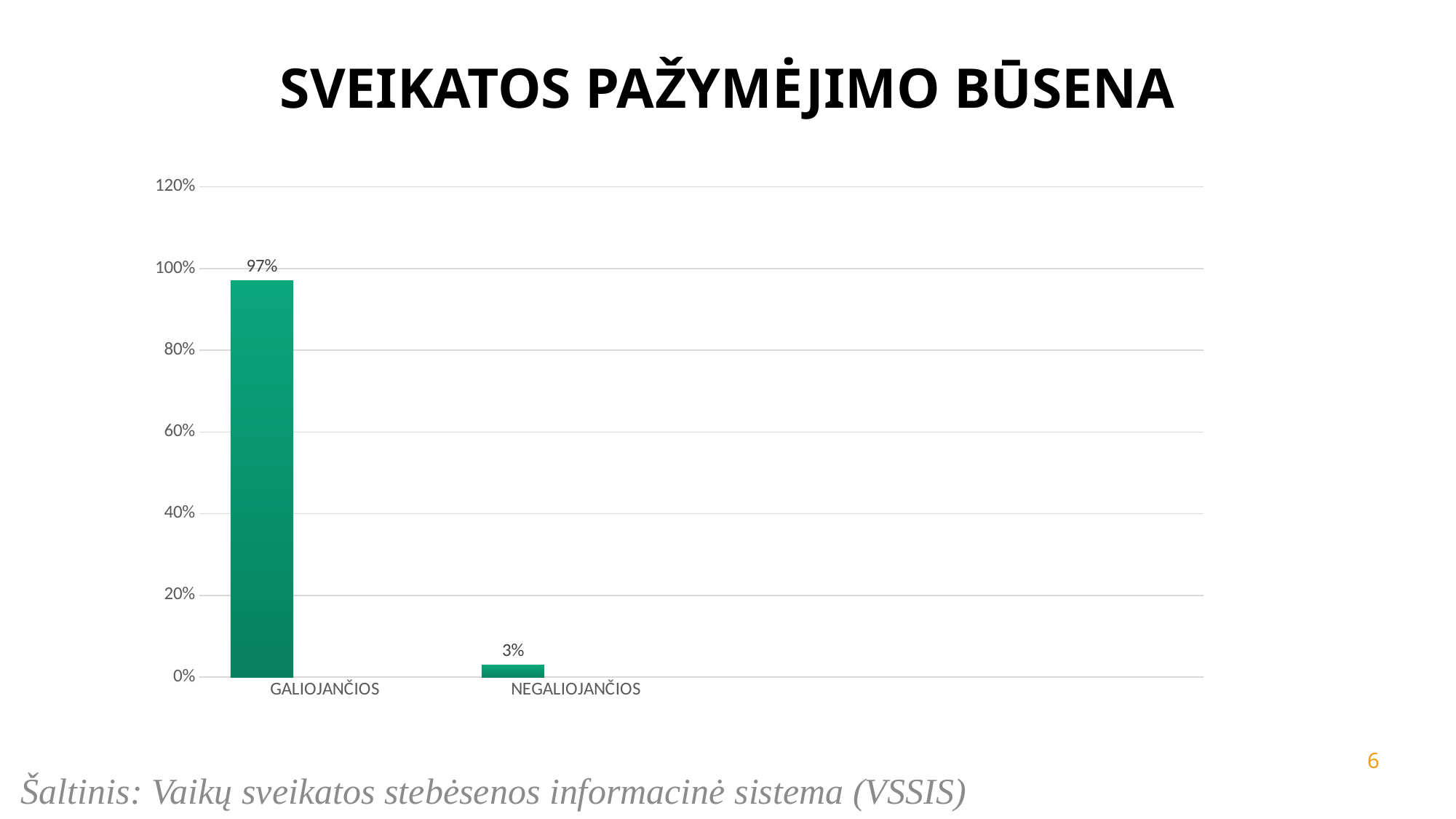
What is the value for GALIOJANČIOS? 97% Is the value for NEGALIOJANČIOS greater or less than 20%? less How many categories are shown on the chart? 2 What is the title of the slide? SVEIKATOS PAŽYMĖJIMO BŪSENA Is the value for GALIOJANČIOS greater or less than 80%? greater Which is larger, the value for GALIOJANČIOS or the value for NEGALIOJANČIOS? GALIOJANČIOS Which category has the lowest value? NEGALIOJANČIOS Which category has the highest value? GALIOJANČIOS What is the highest value shown on the vertical axis? 120% What is the value for NEGALIOJANČIOS? 3% What kind of chart is shown on the slide? bar chart What is the difference between the values for GALIOJANČIOS and NEGALIOJANČIOS? 94%